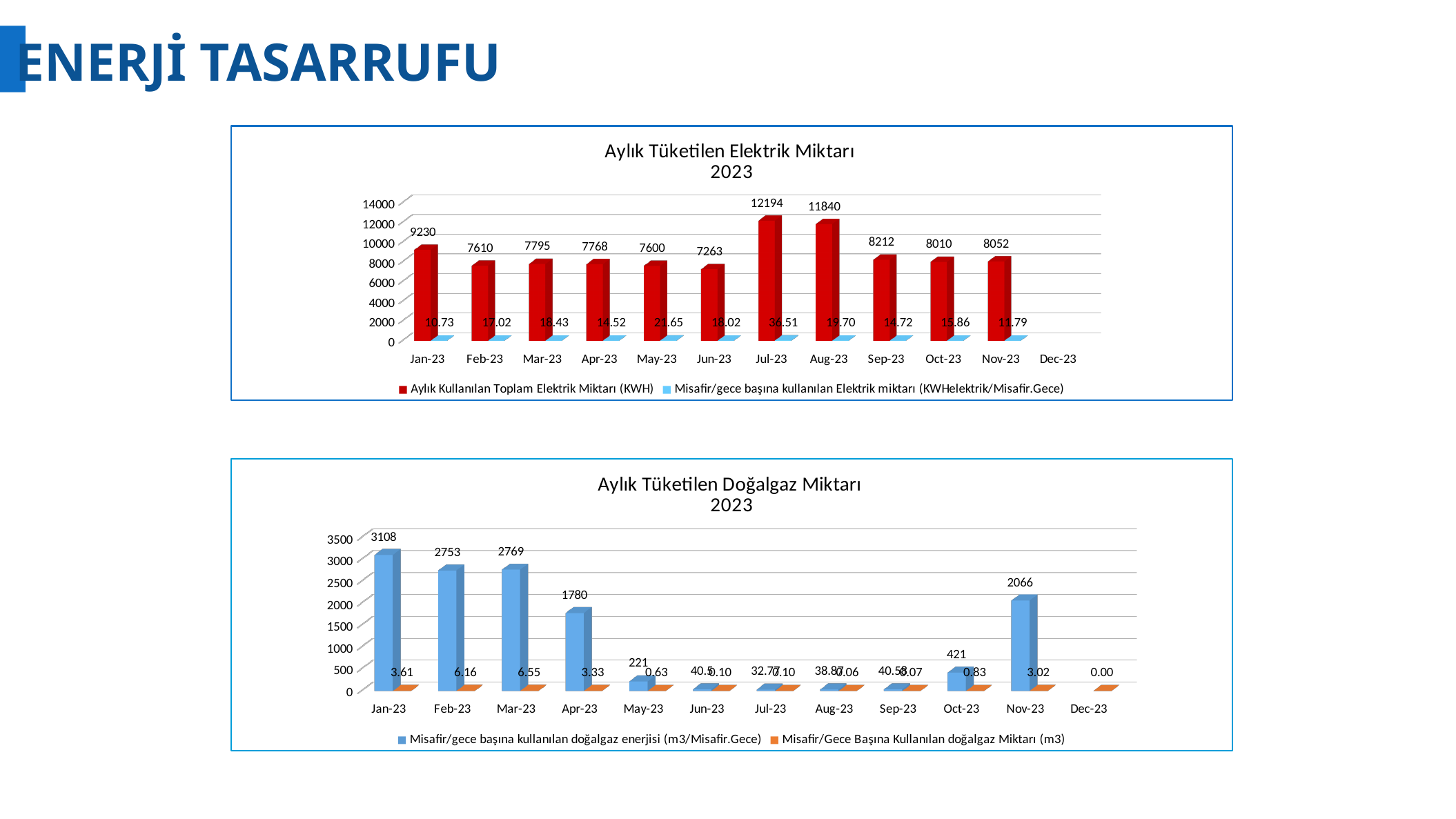
In the bottom chart (Aylık Tüketilen Doğalgaz Miktarı), what is the value of the blue series for Jan-23? 3108 In the bottom chart (Aylık Tüketilen Doğalgaz Miktarı), what is the value of the orange series for Feb-23? 6.16 In the bottom chart (Aylık Tüketilen Doğalgaz Miktarı), which month has the larger blue-series value, Feb-23 or Mar-23? Mar-23 How many series does the legend of the top chart (Aylık Tüketilen Elektrik Miktarı) list? 2 In the bottom chart (Aylık Tüketilen Doğalgaz Miktarı), what is the value of the blue series for Nov-23? 2066 In the top chart (Aylık Tüketilen Elektrik Miktarı), which month shows the lowest labelled total electricity consumption (KWH)? Jun-23 In the top chart (Aylık Tüketilen Elektrik Miktarı), what is the electricity used per guest/night for Jul-23? 36.51 In the bottom chart (Aylık Tüketilen Doğalgaz Miktarı), is the blue-series value for Apr-23 greater or less than 2000? less In the top chart (Aylık Tüketilen Elektrik Miktarı), which month has the highest total electricity consumption (KWH)? Jul-23 What kind of chart is the top chart titled 'Aylık Tüketilen Elektrik Miktarı 2023'? Bar chart In the top chart (Aylık Tüketilen Elektrik Miktarı), what is the difference between the total electricity consumption (KWH) in Jul-23 and Aug-23? 354 In the top chart (Aylık Tüketilen Elektrik Miktarı), what is the total electricity consumption (KWH) for Jul-23? 12194